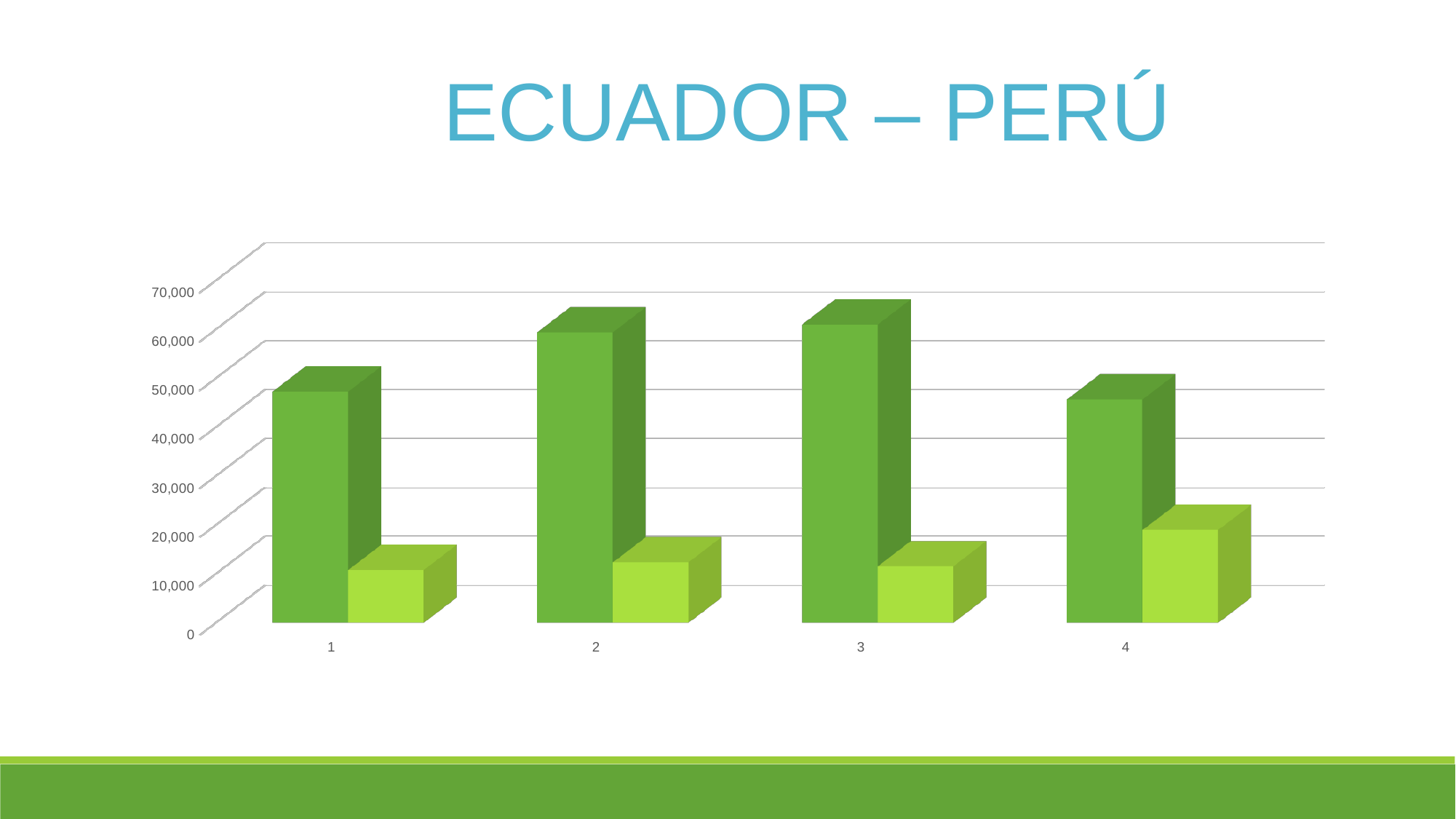
What type of chart is shown on the slide? bar chart Which category has the highest light green bar? 4 Does the dark green series rise or fall from category 3 to category 4? fall Which is larger, the dark green bar for category 2 or for category 1? category 2 How many categories are shown on the x axis? 4 Is the dark green bar for category 3 greater or less than 50,000? greater Which is larger at category 1, the dark green bar or the light green bar? dark green How many series are plotted in the chart? 2 Is the light green bar for category 1 greater or less than 20,000? less Is the dark green bar for category 1 greater or less than 40,000? greater What is the title of the chart? ECUADOR – PERÚ